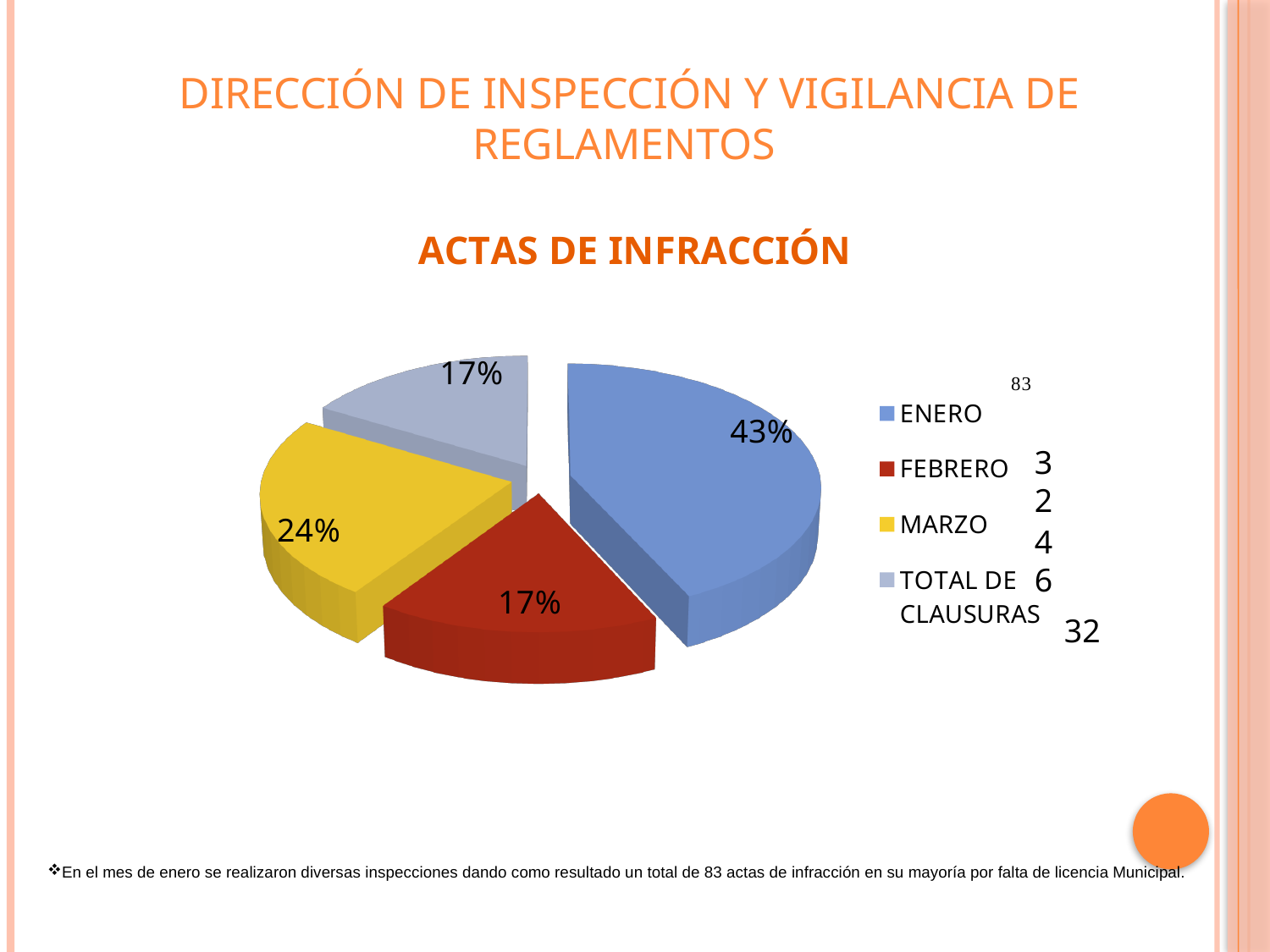
What share of the pie does ENERO represent? 43% What is the difference in percentage points between the ENERO slice and the MARZO slice? 19% What percentage is shown for FEBRERO? 17% What type of chart is shown on the slide? Pie chart How many slices does the pie chart have? 4 What is the title of the chart? ACTAS DE INFRACCIÓN What share of the pie is labelled TOTAL DE CLAUSURAS? 17% Which is larger, the slice for ENERO or the slice for MARZO? ENERO How many entries does the legend list? 4 Which category has the largest slice of the pie? ENERO What percentage is shown for MARZO? 24% Which is larger, the slice for MARZO or the slice for FEBRERO? MARZO